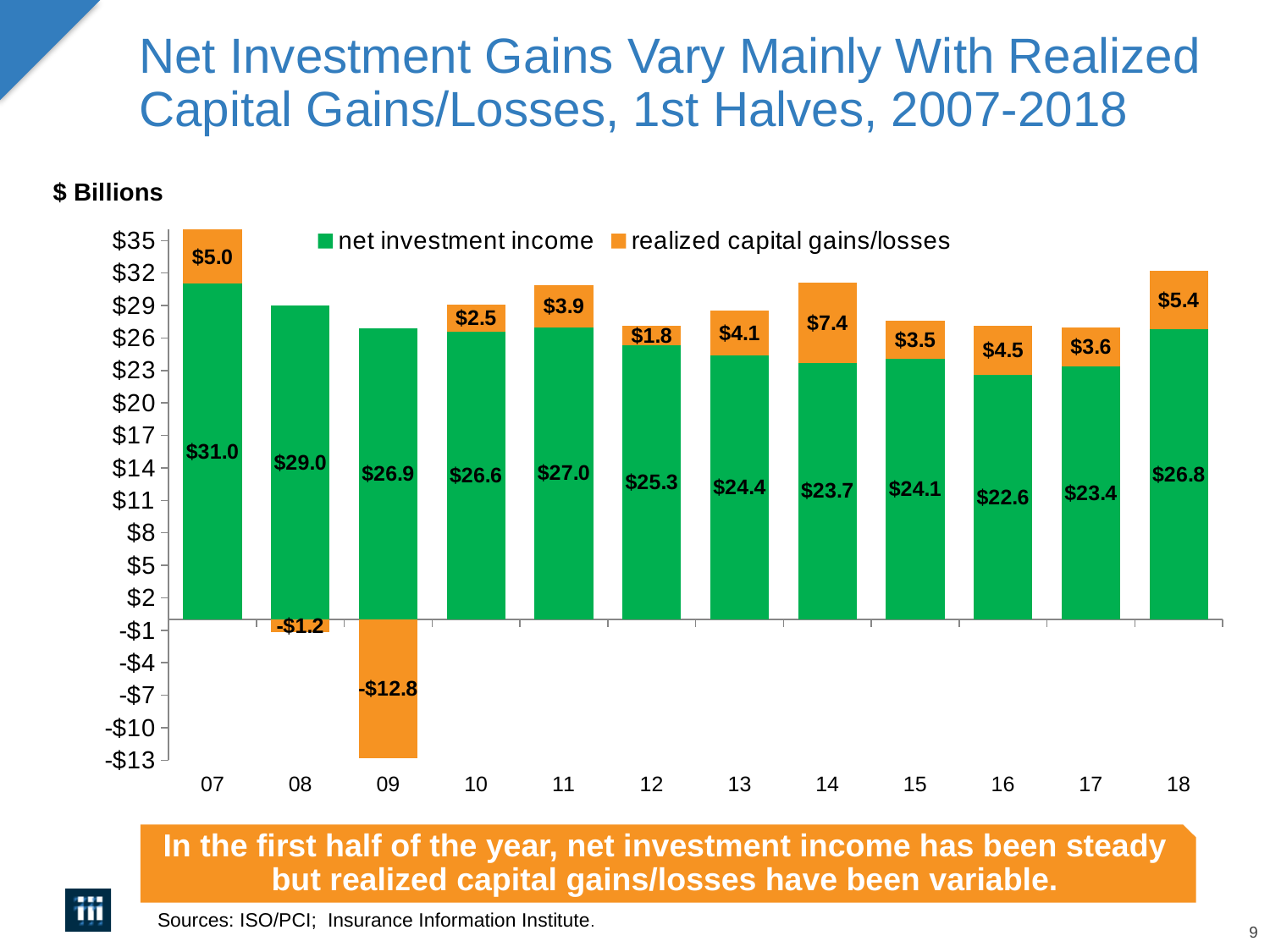
What is the realized capital gains/losses value for 2014 (14)? $7.4 Which year has the lowest net investment income? 16 What is the net investment income value for 2007 (07)? $31.0 What kind of chart is shown on the slide? Stacked bar chart Which year has the lowest realized capital gains/losses value? 09 How many series does the legend list? 2 Which year has the highest net investment income? 07 Which is larger, net investment income in 11 or in 17? 11 What is the realized capital gains/losses value for 2009 (09)? -$12.8 What is the total of the stacked bar for 18 (net investment income plus realized capital gains/losses)? $32.2 How many years are shown on the x axis? 12 What is the difference between net investment income in 07 and in 16? $8.4